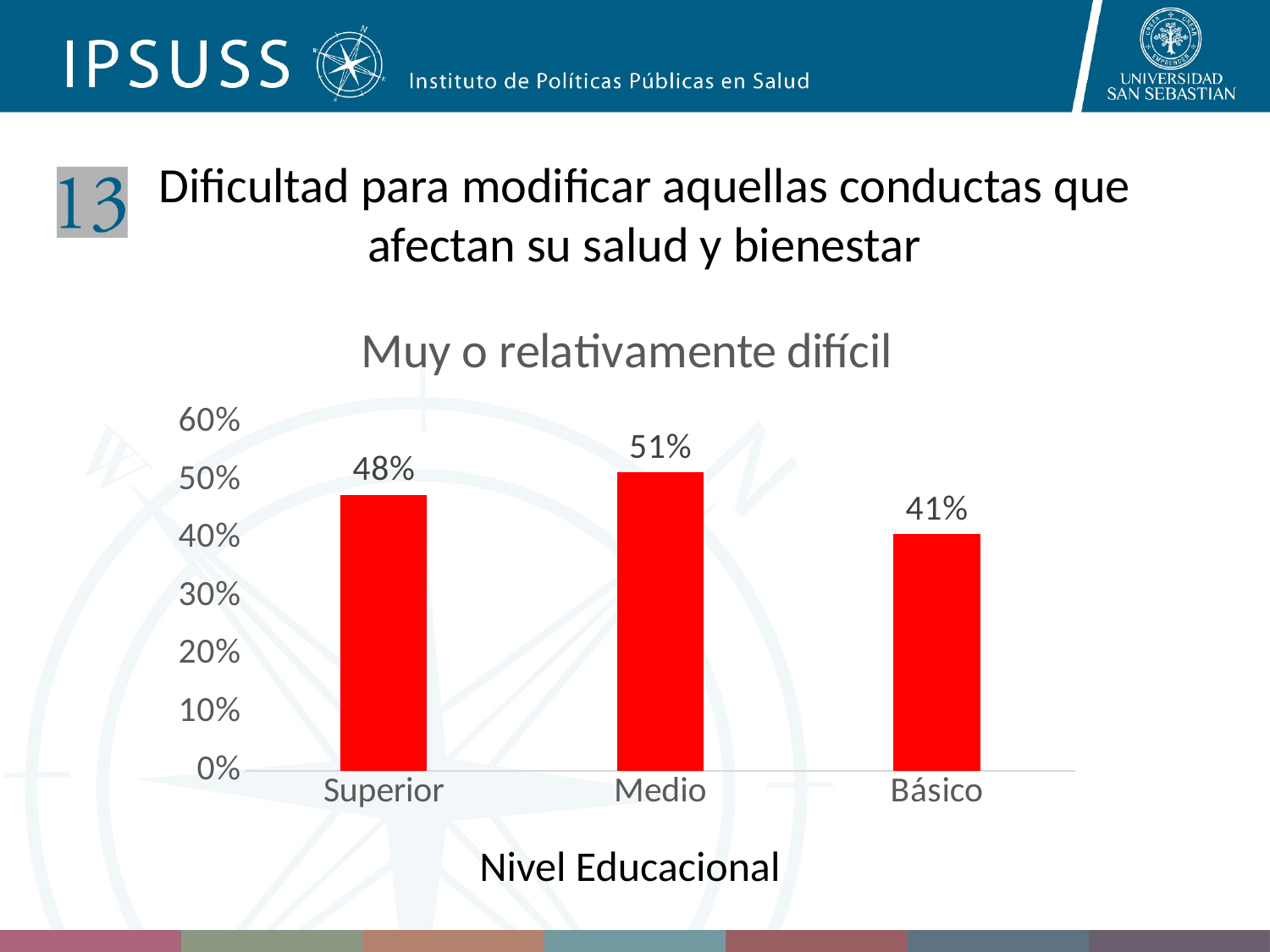
What is the difference between the values for Medio and Básico? 10% What is the value for Medio? 51% How many educational levels are shown on the chart? 3 What is the value for Básico? 41% Which educational level has the lowest value? Básico Which educational level has the highest value? Medio What is the title of the chart? Muy o relativamente difícil What is the value for Superior? 48% What kind of chart is shown on the slide? bar chart Which is larger, the value for Superior or the value for Básico? Superior Is the value for Básico greater or less than 50%? less What is the difference between the values for Medio and Superior? 3%